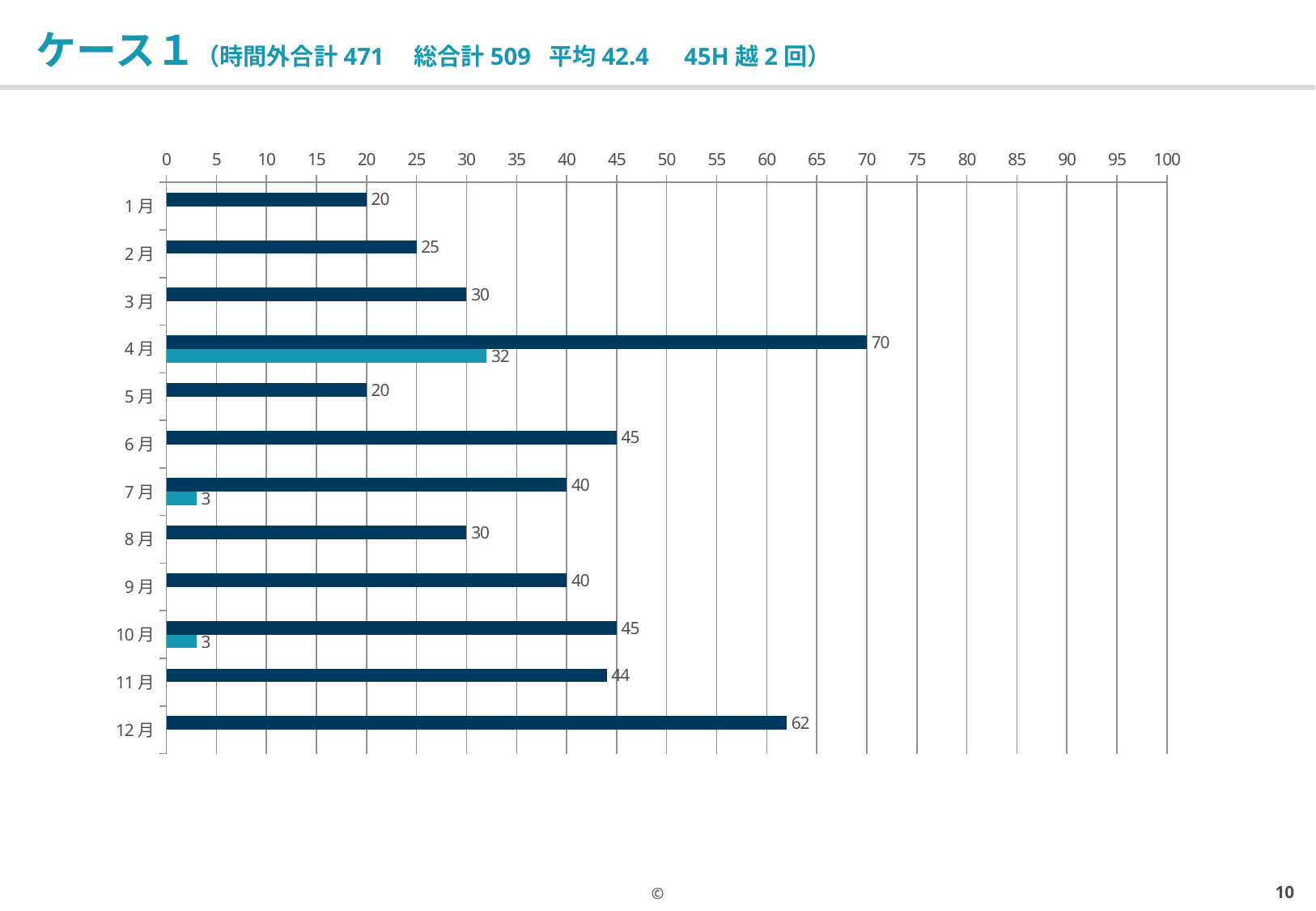
What is the maximum value shown on the horizontal axis? 100 Which has a larger dark blue bar value, 6月 or 9月? 6月 How many months have a light blue bar in addition to the dark blue bar? 3 What is the value of the dark blue bar for 12月? 62 What is the difference between the dark blue bar values for 12月 and 11月? 18 What is the value of the dark blue bar for 4月? 70 What is the value of the light blue bar for 7月? 3 Which month has the highest dark blue bar value? 4月 What type of chart is shown on the slide? bar chart Is the dark blue bar value for 12月 greater or less than 60? greater What is the value of the light blue bar for 4月? 32 How many months are shown on the vertical axis? 12